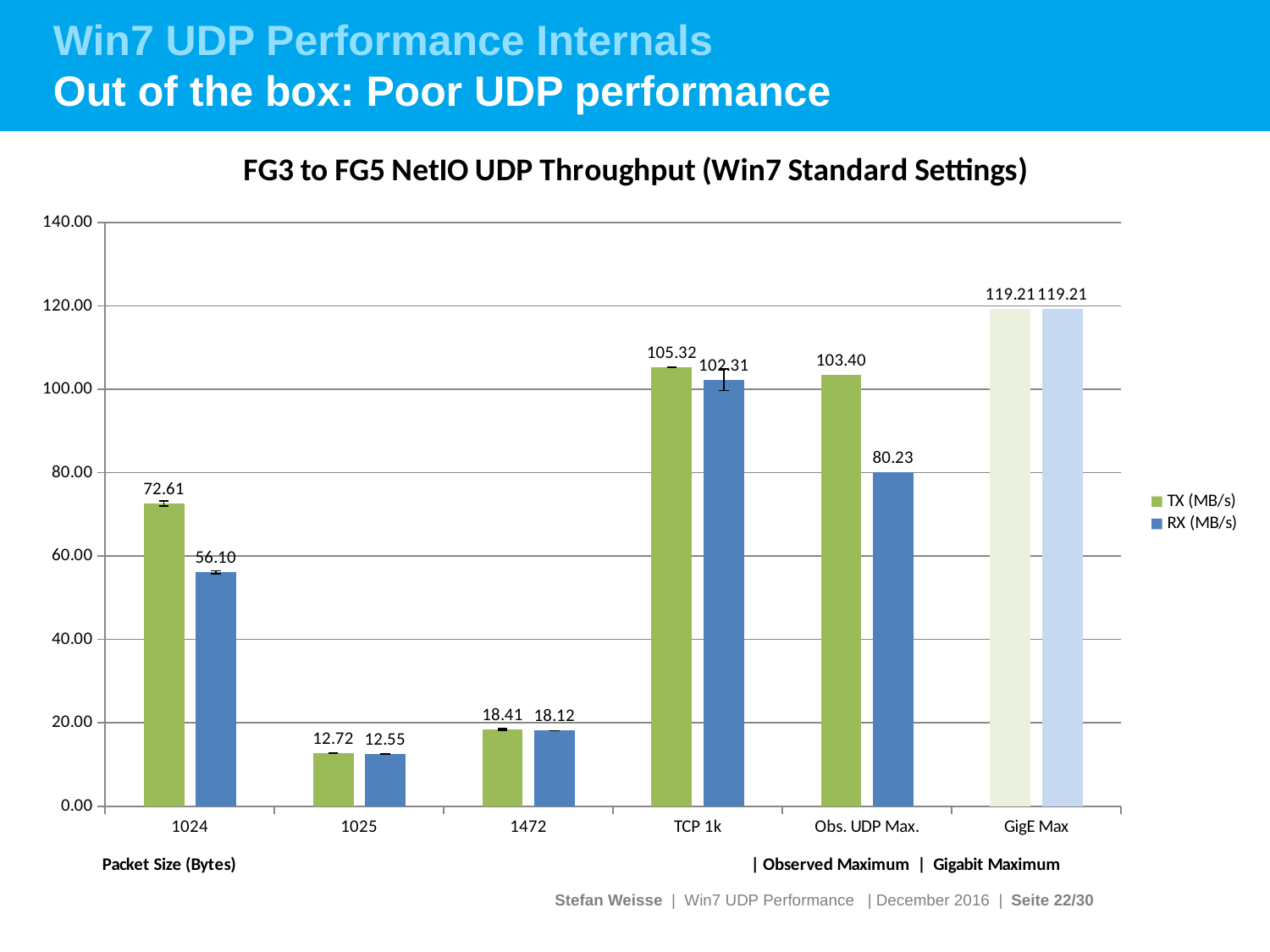
What is the difference between the TX and RX values for packet size 1024? 16.51 How many series does the legend list? 2 How many categories are shown on the x axis? 6 Is the RX (MB/s) value for Obs. UDP Max. greater or less than 100? less What is the TX (MB/s) value for packet size 1024? 72.61 Which category has the highest RX (MB/s) value? GigE Max Which category has the lowest TX (MB/s) value? 1025 What is the title of the chart? FG3 to FG5 NetIO UDP Throughput (Win7 Standard Settings) What is the RX (MB/s) value for Obs. UDP Max.? 80.23 What kind of chart is shown on the slide? bar chart Which is larger, the TX value for 1472 or the TX value for 1025? TX value for 1472 What is the RX (MB/s) value for TCP 1k? 102.31